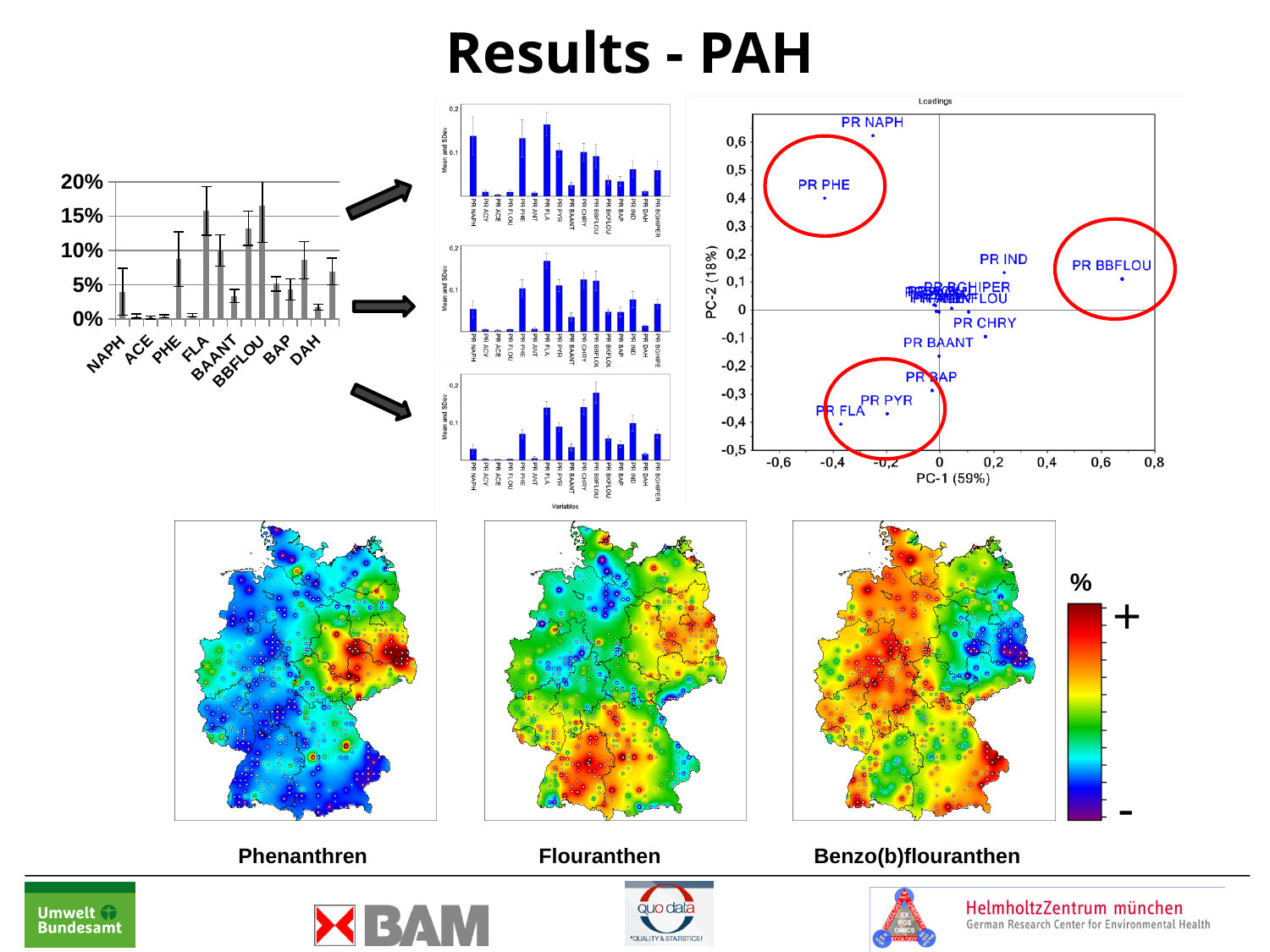
What kind of chart is the large grey chart on the left of the slide? bar chart On the scatter plot titled Loadings, which point has the highest PC-2 value? PR NAPH On the grey bar chart on the left, is the value for BBFLOU greater or less than 10%? greater On the grey bar chart on the left, what is the highest value shown on the vertical axis? 20% On the grey bar chart on the left, is the value for DAH greater or less than 5%? less On the scatter plot titled Loadings, which point has the highest PC-1 value? PR BBFLOU On the grey bar chart on the left, is the value for FLA greater or less than 10%? greater On the scatter plot titled Loadings, which point has a higher PC-2 value, PR IND or PR CHRY? PR IND On the scatter plot titled Loadings, what is the label of the horizontal axis? PC-1 (59%) On the grey bar chart on the left, how many category labels are printed along the horizontal axis? 8 How many maps of Germany are shown at the bottom of the slide? 3